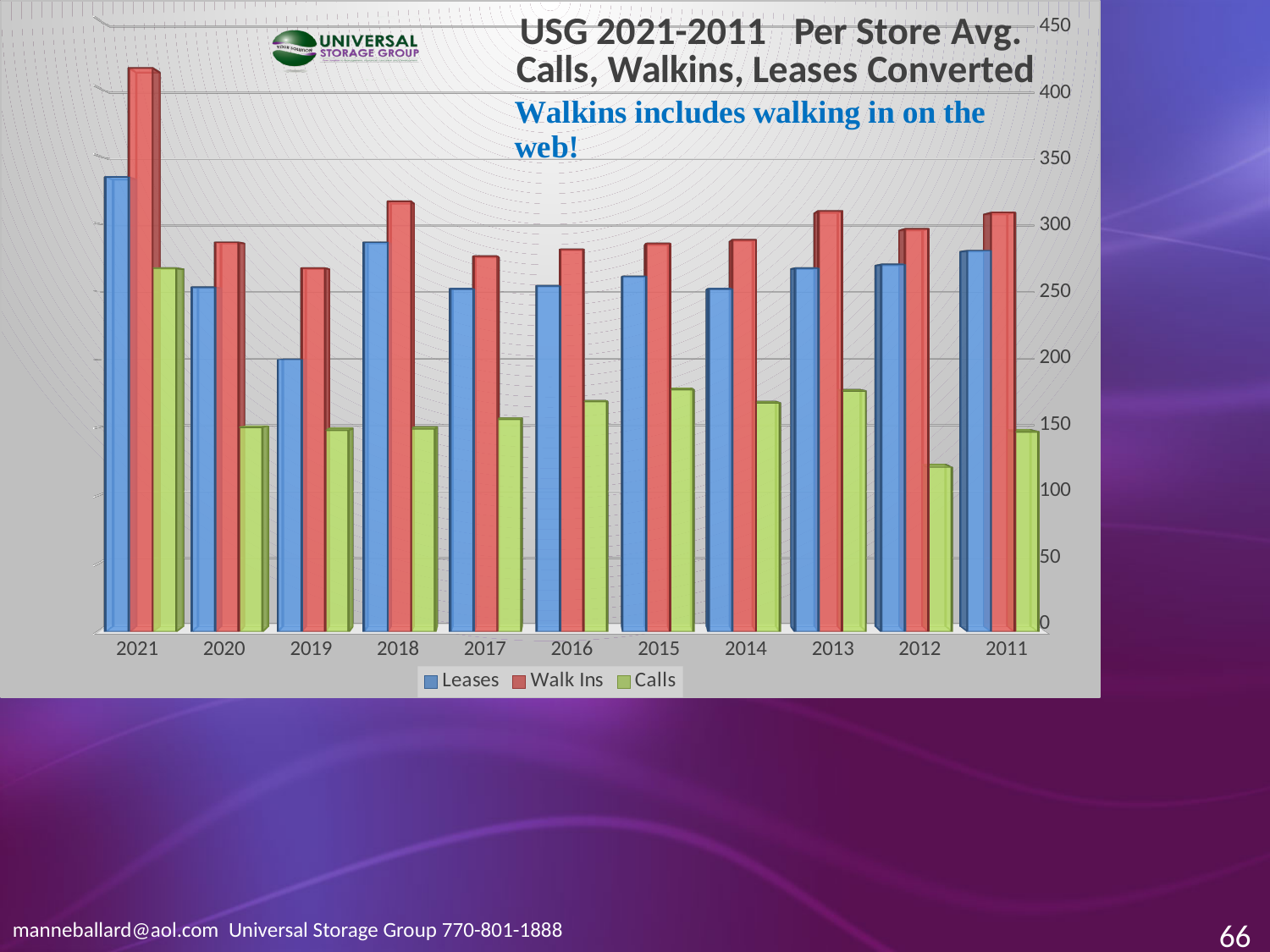
How many years are shown along the x axis of the chart? 11 Is the Leases value for 2021 greater or less than 300? greater In which year is the Calls value lowest? 2012 Is the Walk Ins value for 2021 greater or less than 400? greater In which year is the Walk Ins value highest? 2021 In which year is the Leases value lowest? 2019 Which series are listed in the chart legend? Leases, Walk Ins, Calls In 2021, which is larger: Walk Ins or Leases? Walk Ins How many series does the chart legend list? 3 Which series is shown in green in the chart? Calls Is the Calls value for 2012 greater or less than 150? less What kind of chart is shown on the slide? bar chart